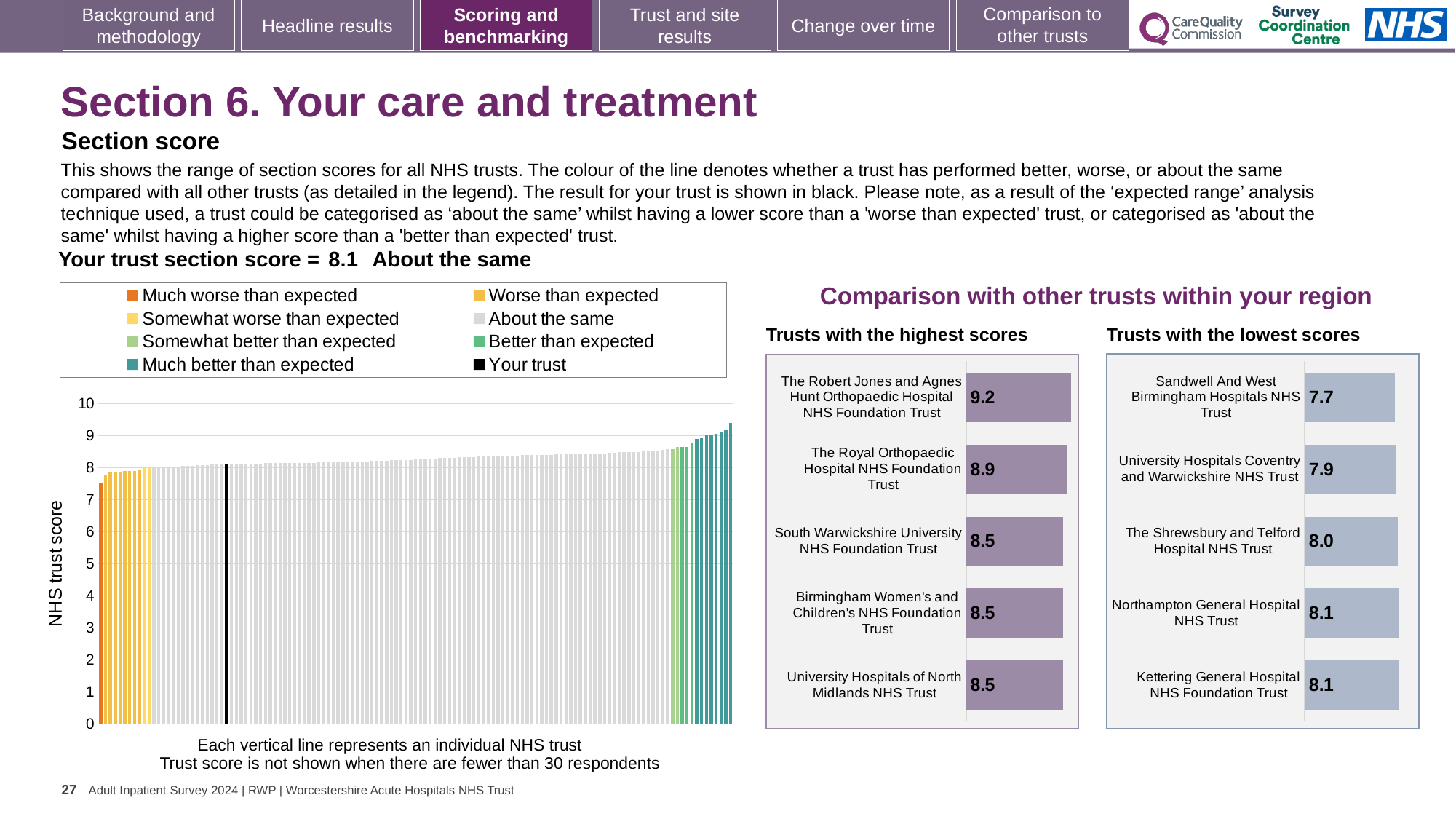
In the left-hand NHS trust score chart, is the value of the shortest bar greater or less than 8? less What is the section score for your trust shown on the slide? 8.1 In the 'Trusts with the highest scores' chart, what is the difference between the scores of The Robert Jones and Agnes Hunt Orthopaedic Hospital NHS Foundation Trust and South Warwickshire University NHS Foundation Trust? 0.7 In the 'Trusts with the lowest scores' chart, which has the larger score: University Hospitals Coventry and Warwickshire NHS Trust or Northampton General Hospital NHS Trust? Northampton General Hospital NHS Trust How many entries does the legend of the left-hand NHS trust score chart list? 8 In the left-hand NHS trust score chart, do the bars rise or fall from left to right along the x axis? rise What kind of chart is the large chart on the left showing NHS trust scores? bar chart In the 'Trusts with the highest scores' chart, which trust has the highest score? The Robert Jones and Agnes Hunt Orthopaedic Hospital NHS Foundation Trust In the left-hand NHS trust score chart, is the value of the tallest bar greater or less than 9? greater How many trusts are listed in the 'Trusts with the lowest scores' chart? 5 In the 'Trusts with the lowest scores' chart, which trust has the lowest score? Sandwell And West Birmingham Hospitals NHS Trust In the 'Trusts with the highest scores' chart, what is the score for The Royal Orthopaedic Hospital NHS Foundation Trust? 8.9